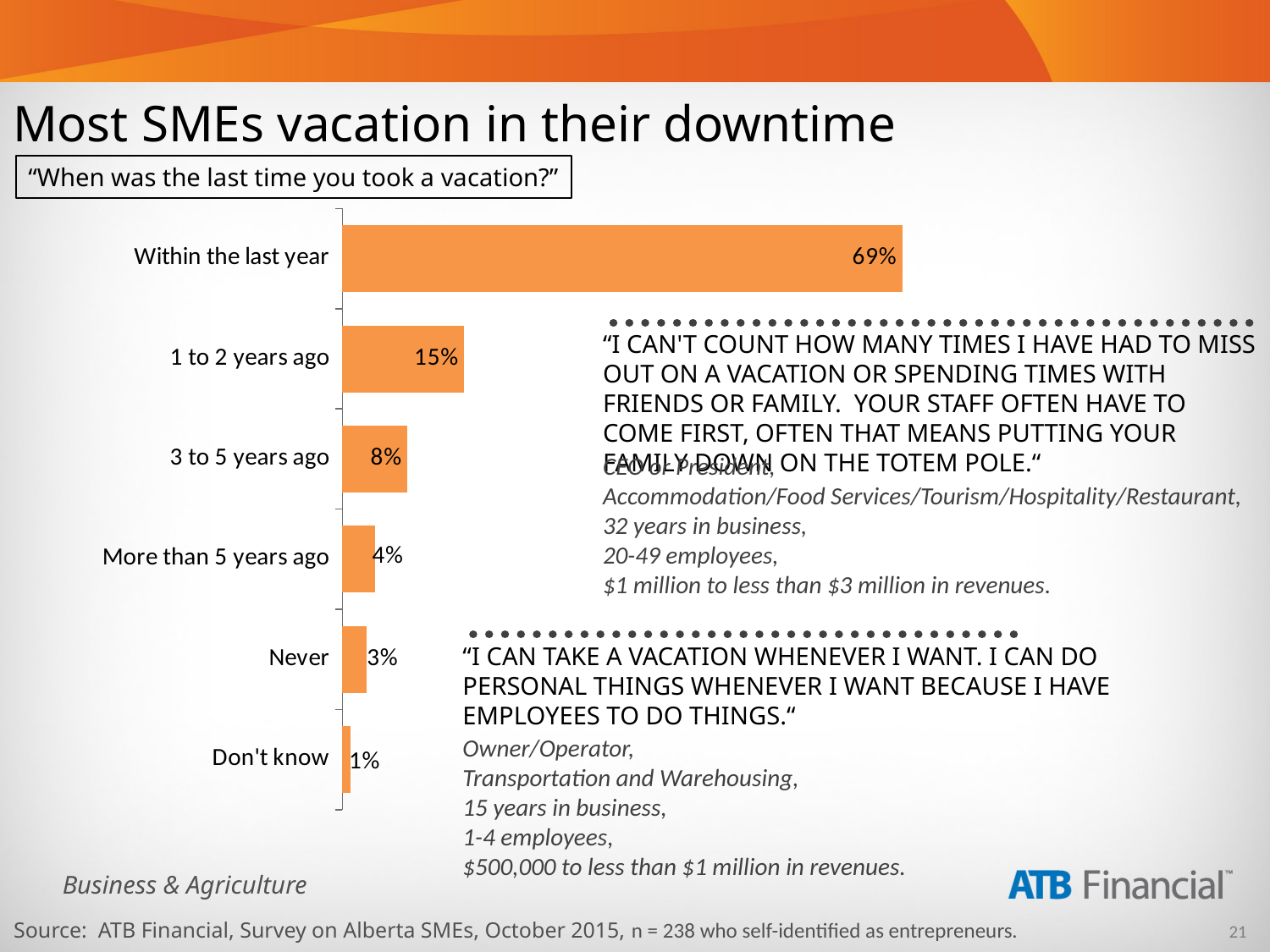
What is the value for "Don't know"? 1% What survey question is the chart based on? "When was the last time you took a vacation?" Which is larger, the value for "3 to 5 years ago" or the value for "Never"? 3 to 5 years ago What percentage of respondents took a vacation within the last year? 69% What kind of chart is shown on the slide? Bar chart What is the value for "1 to 2 years ago"? 15% Which category has the highest value? Within the last year Which category has the lowest value? Don't know What percentage of respondents answered "Never"? 3% What is the difference between "Within the last year" and "1 to 2 years ago"? 54% How many categories are shown in the bar chart? 6 What is the difference between "3 to 5 years ago" and "More than 5 years ago"? 4%